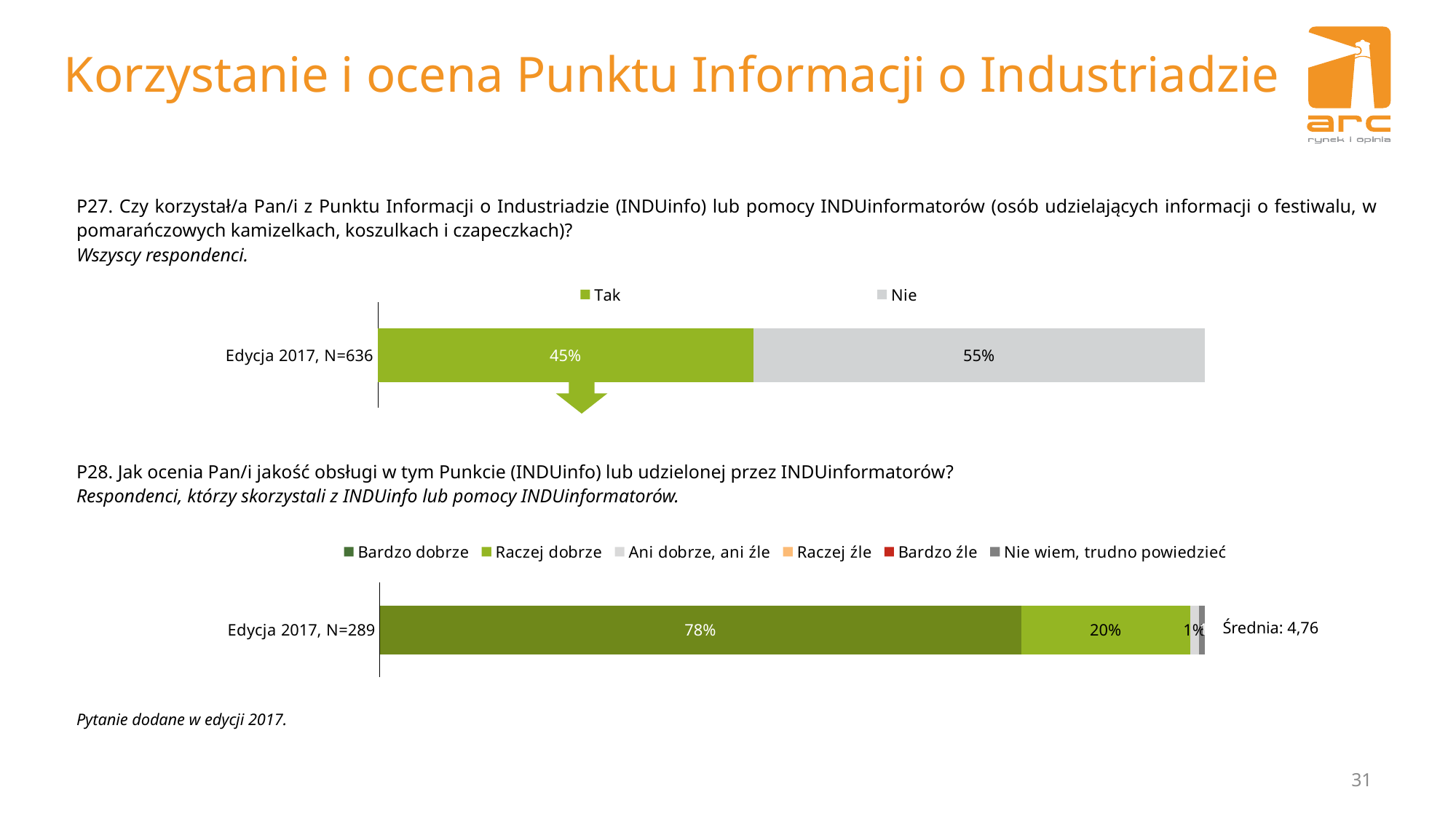
In the bottom chart (P28), which rating category has the highest share? Bardzo dobrze In the top chart (P27), which answer has the larger share, "Tak" or "Nie"? Nie In the bottom chart (P28), what is the average (Średnia) shown next to the bar? 4,76 What type of chart is used for P28 at the bottom of the slide? Stacked bar chart In the bottom chart (P28), what percentage of respondents rated the service "Bardzo dobrze"? 78% In the bottom chart (P28), how many series does the legend list? 6 In the bottom chart (P28), what percentage of respondents rated the service "Raczej dobrze"? 20% In the top chart (P27), what is the sample size (N) shown for Edycja 2017? 636 In the top chart (P27), how many series does the legend list? 2 In the top chart (P27), what percentage of respondents answered "Nie" for Edycja 2017? 55% In the top chart (P27), what is the difference between the "Nie" share and the "Tak" share? 10 percentage points In the top chart (P27), what percentage of respondents answered "Tak" for Edycja 2017? 45%